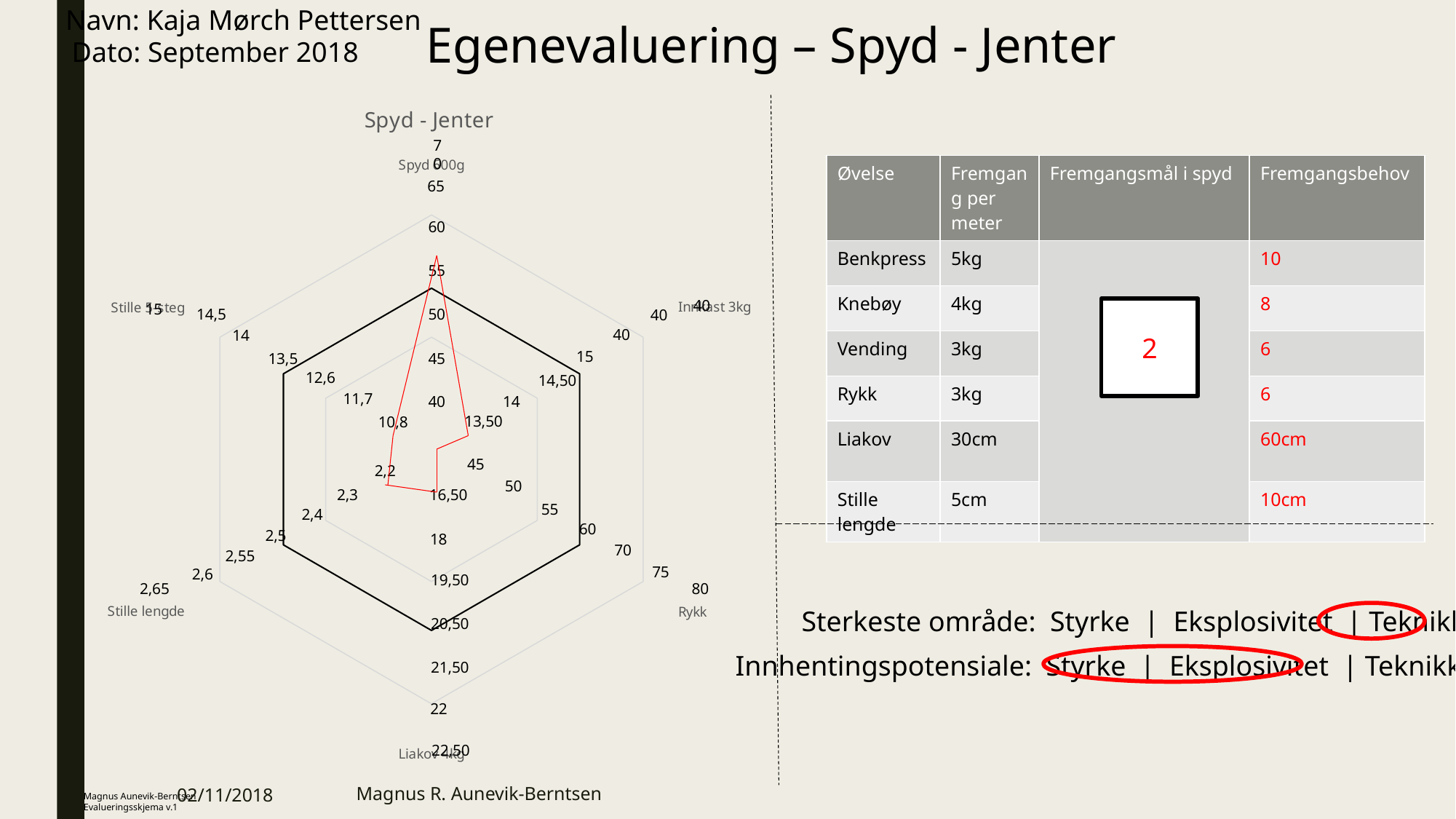
Is the value plotted on the Spyd 600g axis greater or less than 60? less Is the value plotted on the Spyd 600g axis greater or less than 50? greater What kind of chart is shown on the slide? radar chart What is the title of the chart on the left of the slide? Spyd - Jenter How many axes (categories) does the radar chart have? 6